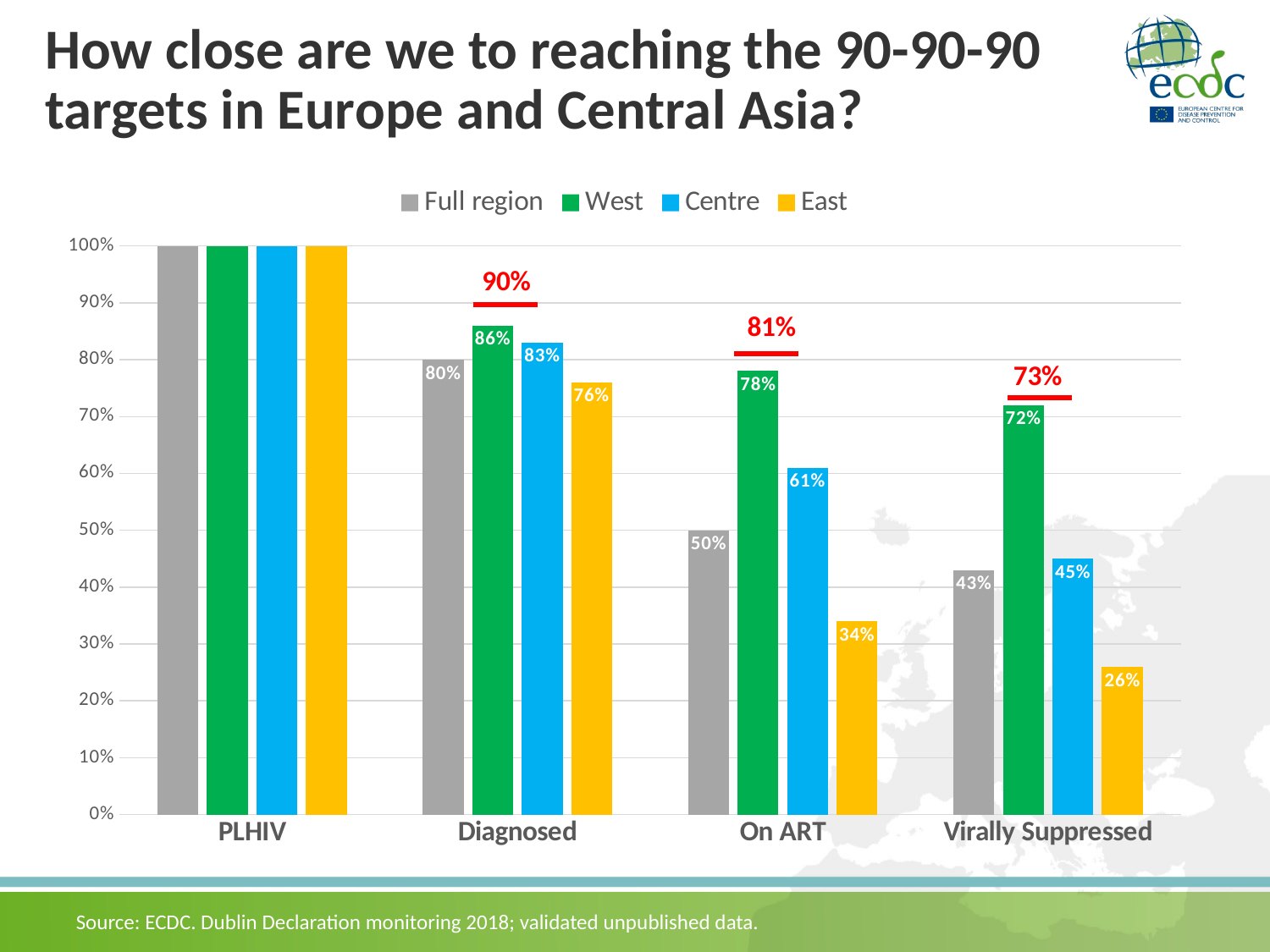
How many series does the legend list? 4 What is the value for Full region in the Virally Suppressed category? 43% What is the difference between the West and East values in the Diagnosed category? 10% What is the value for East in the On ART category? 34% What is the value for West in the Diagnosed category? 86% What kind of chart is shown on the slide? Bar chart How many categories are shown on the x axis? 4 Which series has the lowest value in the Virally Suppressed category? East Which series has the highest value in the On ART category? West What is the value for Centre in the On ART category? 61% What is the red target value shown above the On ART category? 81% Which is larger: the Centre value for Diagnosed or the Centre value for Virally Suppressed? Diagnosed